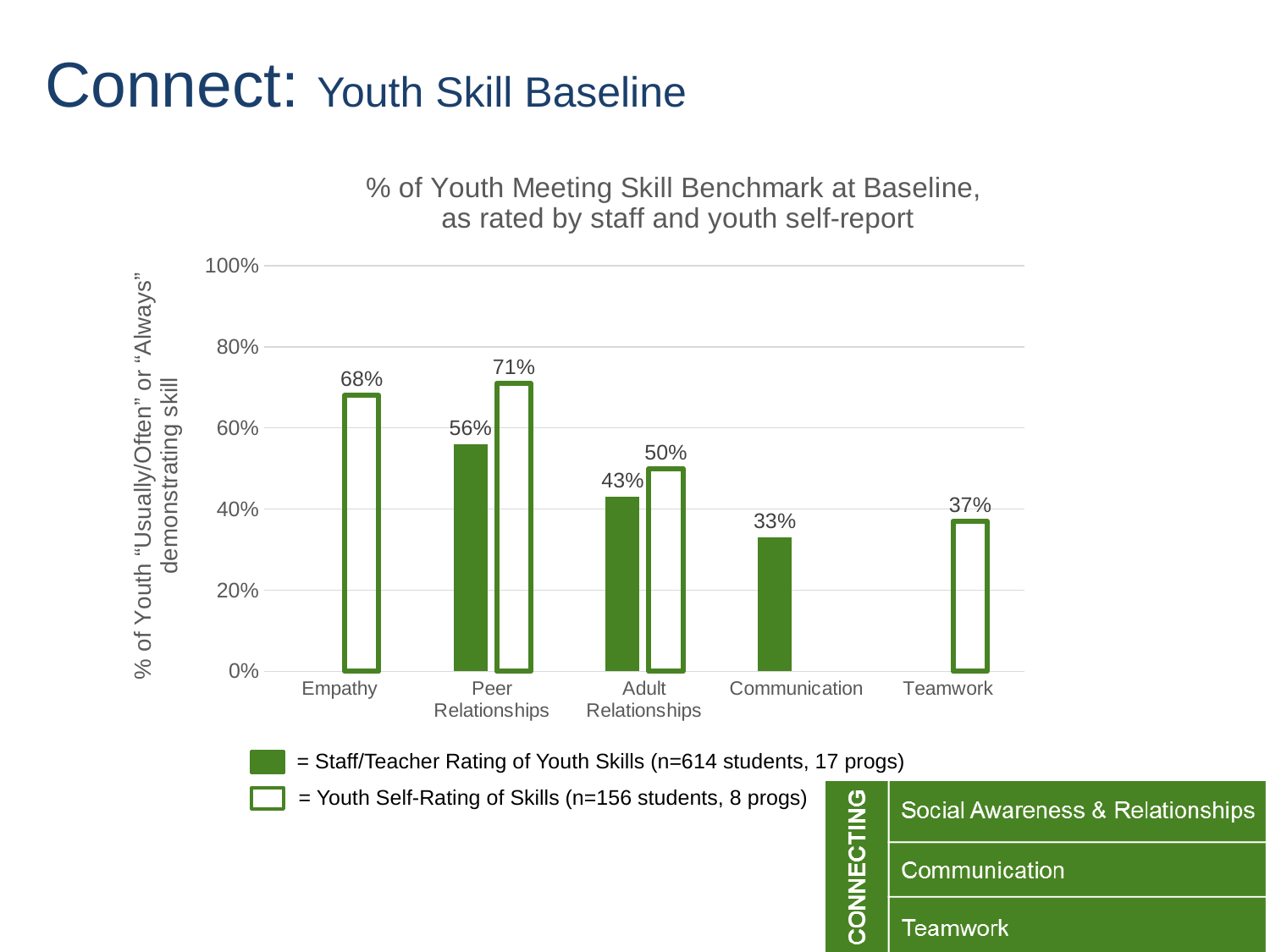
Which category has the highest Youth Self-Rating value? Peer Relationships What is the Staff/Teacher Rating value for Peer Relationships? 56% How many series does the legend list? 2 Which category has the lowest Staff/Teacher Rating value? Communication What kind of chart is shown on the slide? Bar chart According to the legend, how many students were included in the Staff/Teacher Rating of Youth Skills? 614 What is the Youth Self-Rating value for Empathy? 68% What is the Youth Self-Rating value for Teamwork? 37% For Peer Relationships, which is larger: the Staff/Teacher Rating or the Youth Self-Rating? Youth Self-Rating What is the difference between the Youth Self-Rating and Staff/Teacher Rating for Adult Relationships? 7% What is the Staff/Teacher Rating value for Communication? 33% How many skill categories are shown on the x axis? 5